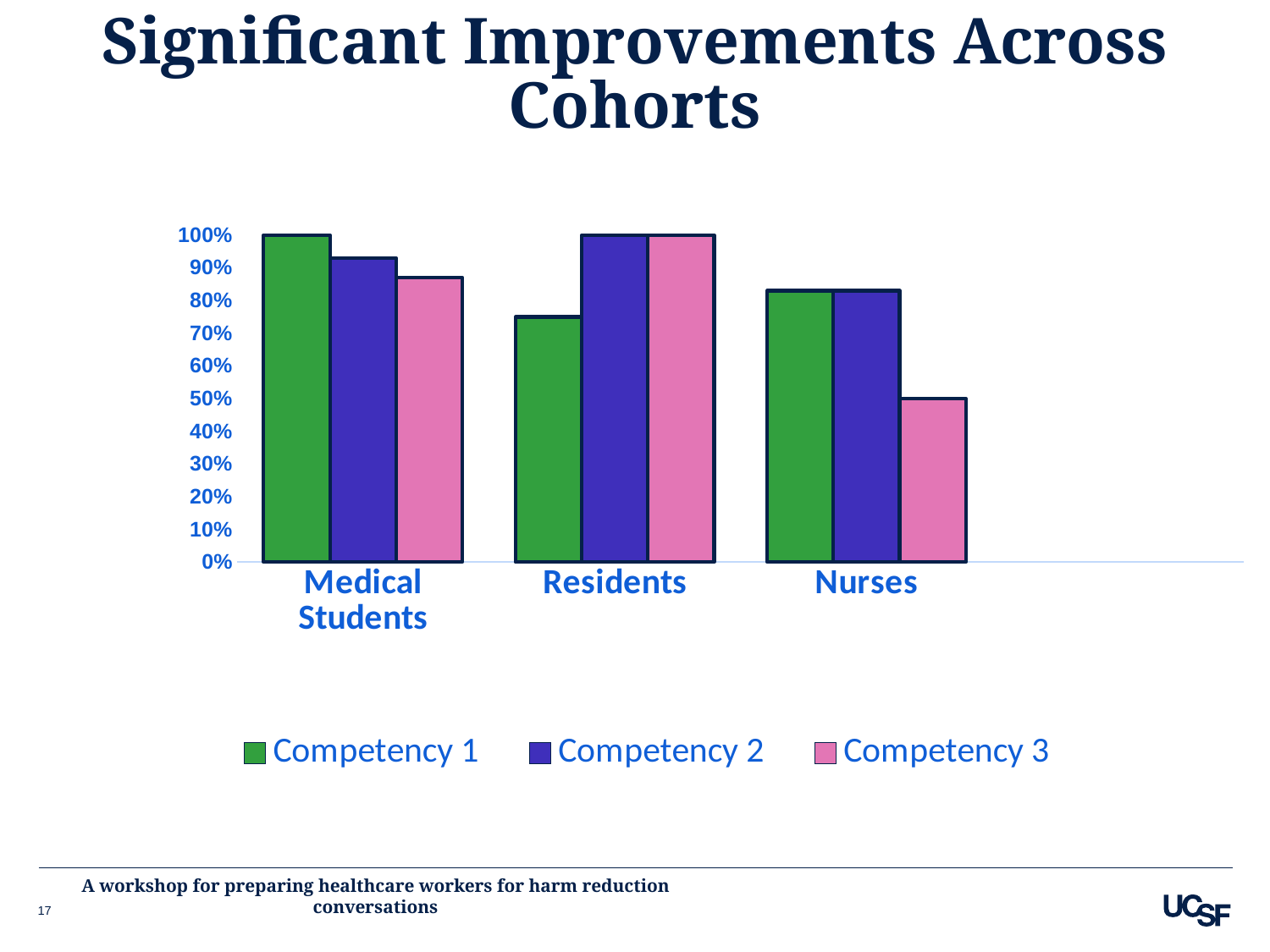
What is the title of the chart on the slide? Significant Improvements Across Cohorts Which cohort has the lowest value for Competency 3? Nurses Which is larger for Residents: Competency 1 or Competency 2? Competency 2 What is the value for Competency 2 for Residents? 100% How many series does the legend list? 3 Is the value for Competency 1 for Nurses greater or less than 80%? greater How many cohorts (categories) are shown on the x axis? 3 Is the value for Competency 2 for Medical Students greater or less than 90%? greater What is the value for Competency 1 for Medical Students? 100% Is the value for Competency 1 for Residents greater or less than 80%? less What is the value for Competency 3 for Nurses? 50% What kind of chart is shown on the slide? bar chart